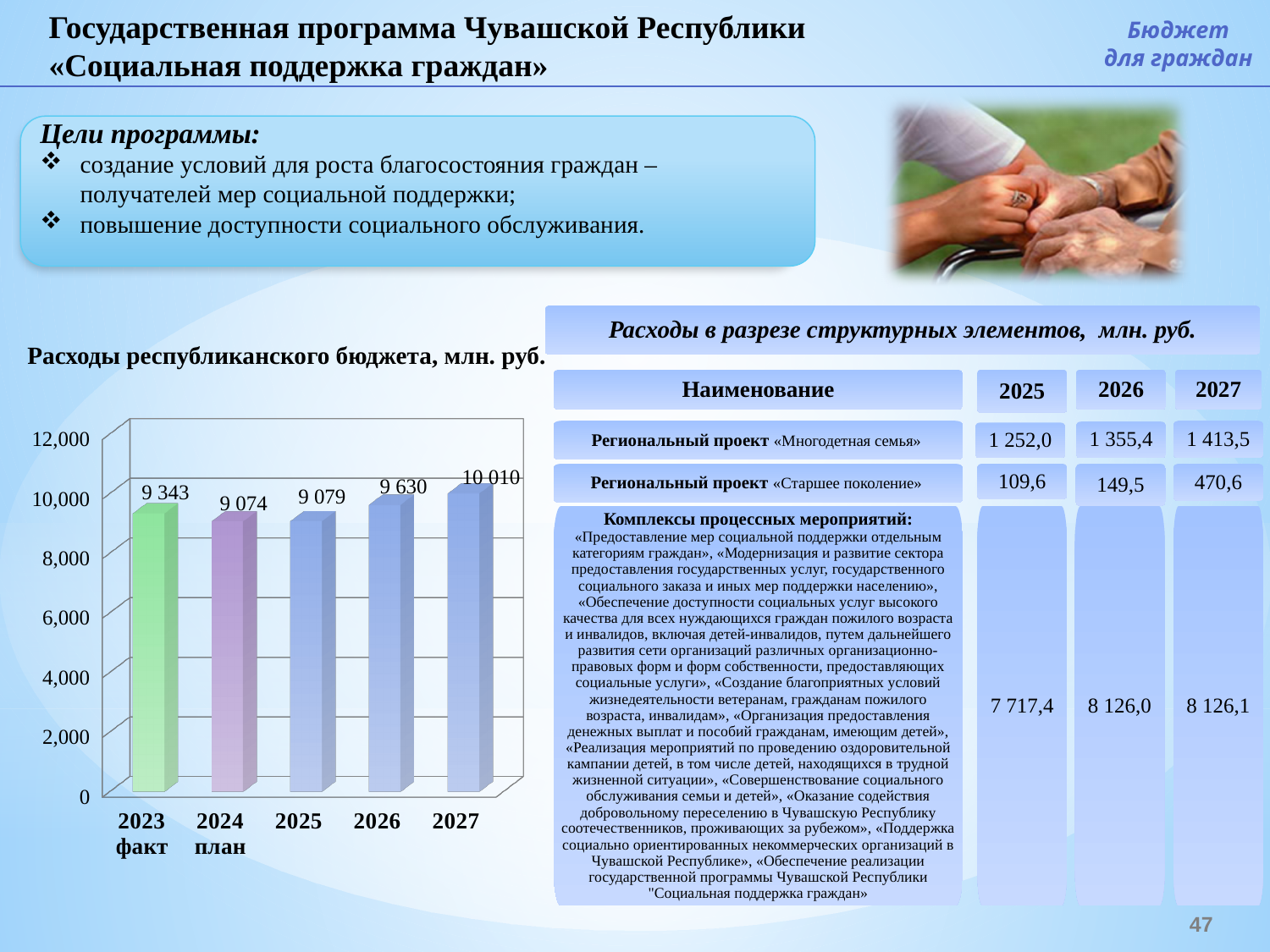
What is the value for 2024 план in the chart «Расходы республиканского бюджета, млн. руб.»? 9 074 In the chart «Расходы республиканского бюджета, млн. руб.», which is larger: the value for 2026 or the value for 2023 факт? 2026 Which year has the highest value in the chart «Расходы республиканского бюджета, млн. руб.»? 2027 In the chart «Расходы республиканского бюджета, млн. руб.», what is the difference between the values for 2027 and 2026? 380 What is the value for 2027 in the chart «Расходы республиканского бюджета, млн. руб.»? 10 010 What is the value for 2023 факт in the chart «Расходы республиканского бюджета, млн. руб.»? 9 343 In the chart «Расходы республиканского бюджета, млн. руб.», is the value for 2027 greater or less than 10,000? greater What is the value for 2025 in the chart «Расходы республиканского бюджета, млн. руб.»? 9 079 How many bars are shown in the chart «Расходы республиканского бюджета, млн. руб.»? 5 In the chart «Расходы республиканского бюджета, млн. руб.», what is the difference between the values for 2023 факт and 2024 план? 269 Which year has the lowest value in the chart «Расходы республиканского бюджета, млн. руб.»? 2024 план What type of chart is shown under the title «Расходы республиканского бюджета, млн. руб.»? bar chart